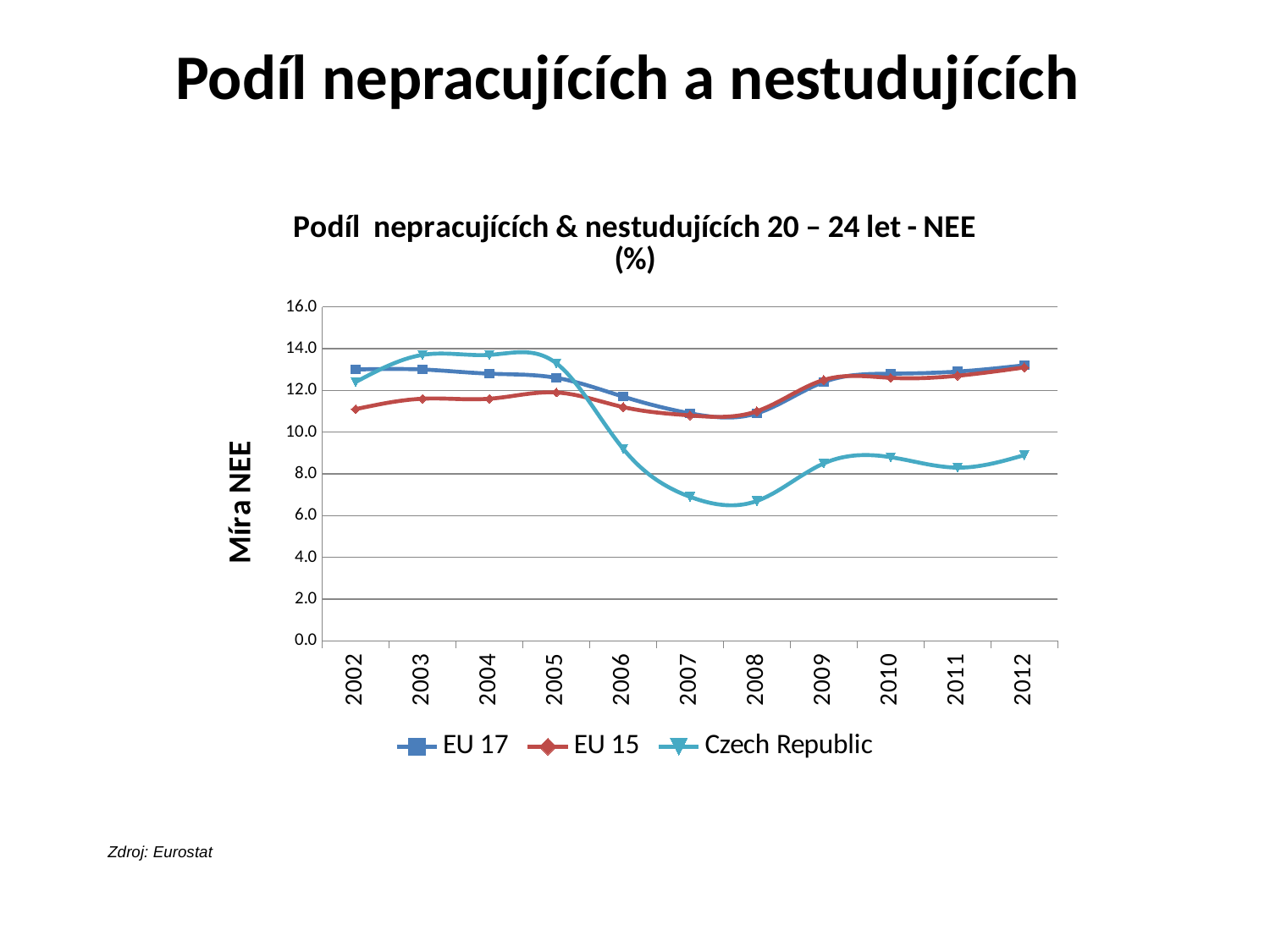
Does the Czech Republic line rise or fall between 2005 and 2008? fall How many years are plotted along the x axis? 11 Is the value for Czech Republic in 2003 greater or less than 12.0? greater Which series has the lowest value in 2010? Czech Republic How many series does the legend list? 3 Is the value for Czech Republic in 2008 greater or less than 8.0? less In 2008, which is larger: EU 17 or Czech Republic? EU 17 In 2003, which is larger: Czech Republic or EU 15? Czech Republic What kind of chart is shown on the slide? line chart What is the label on the vertical axis? Míra NEE Is the value for EU 15 in 2002 greater or less than 10.0? greater